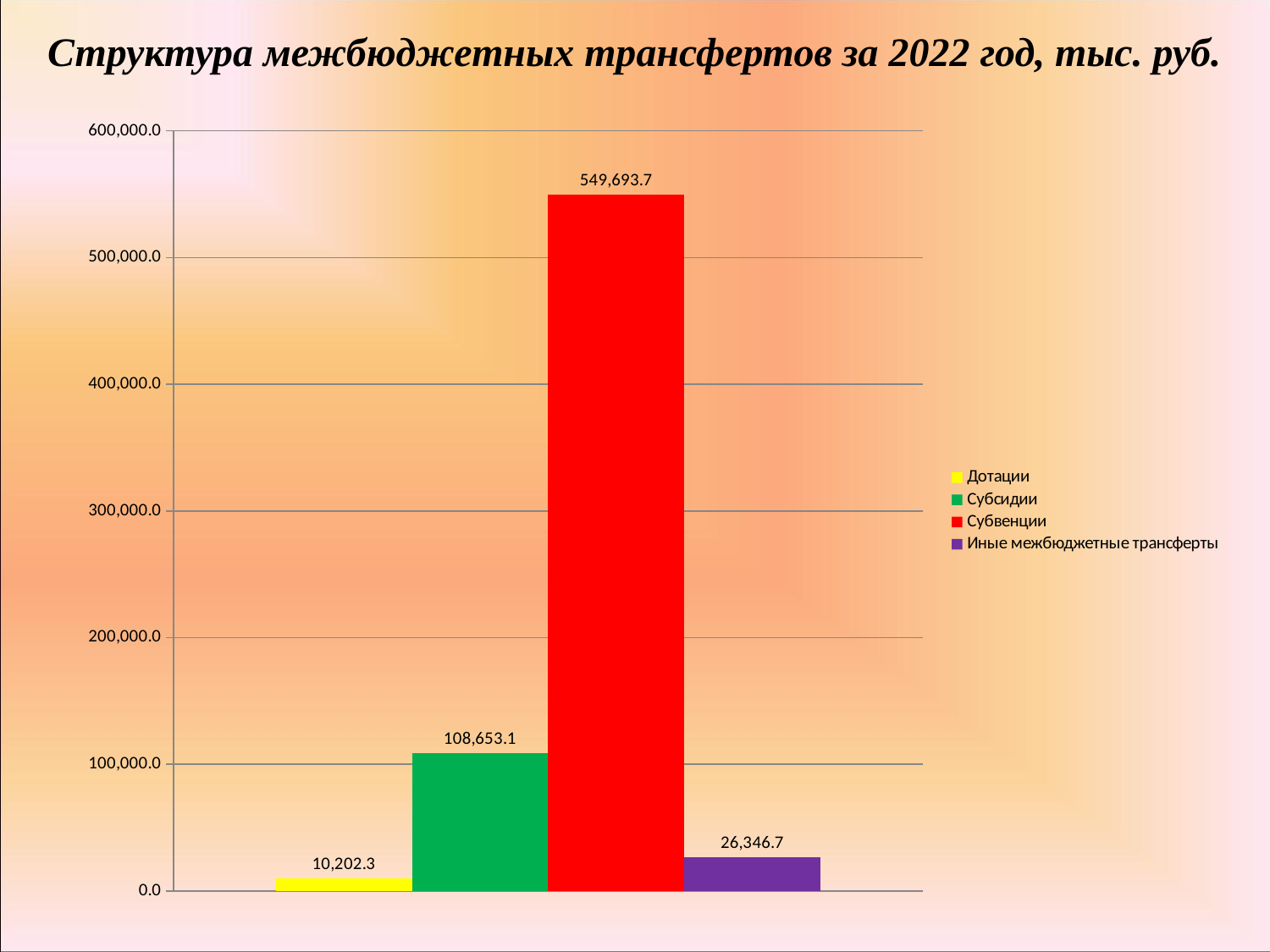
What is the value for Субсидии? 108,653.1 What is the difference between the values for Субвенции and Субсидии? 441,040.6 What is the value for Дотации? 10,202.3 Which category has the highest value? Субвенции What kind of chart is shown on the slide? bar chart What is the value for Иные межбюджетные трансферты? 26,346.7 How many series does the legend list? 4 What colour is the bar for Субвенции? red What is the value for Субвенции? 549,693.7 Is the value for Субвенции greater or less than 500,000.0? greater Which is larger, the value for Субсидии or the value for Иные межбюджетные трансферты? Субсидии Which category has the lowest value? Дотации